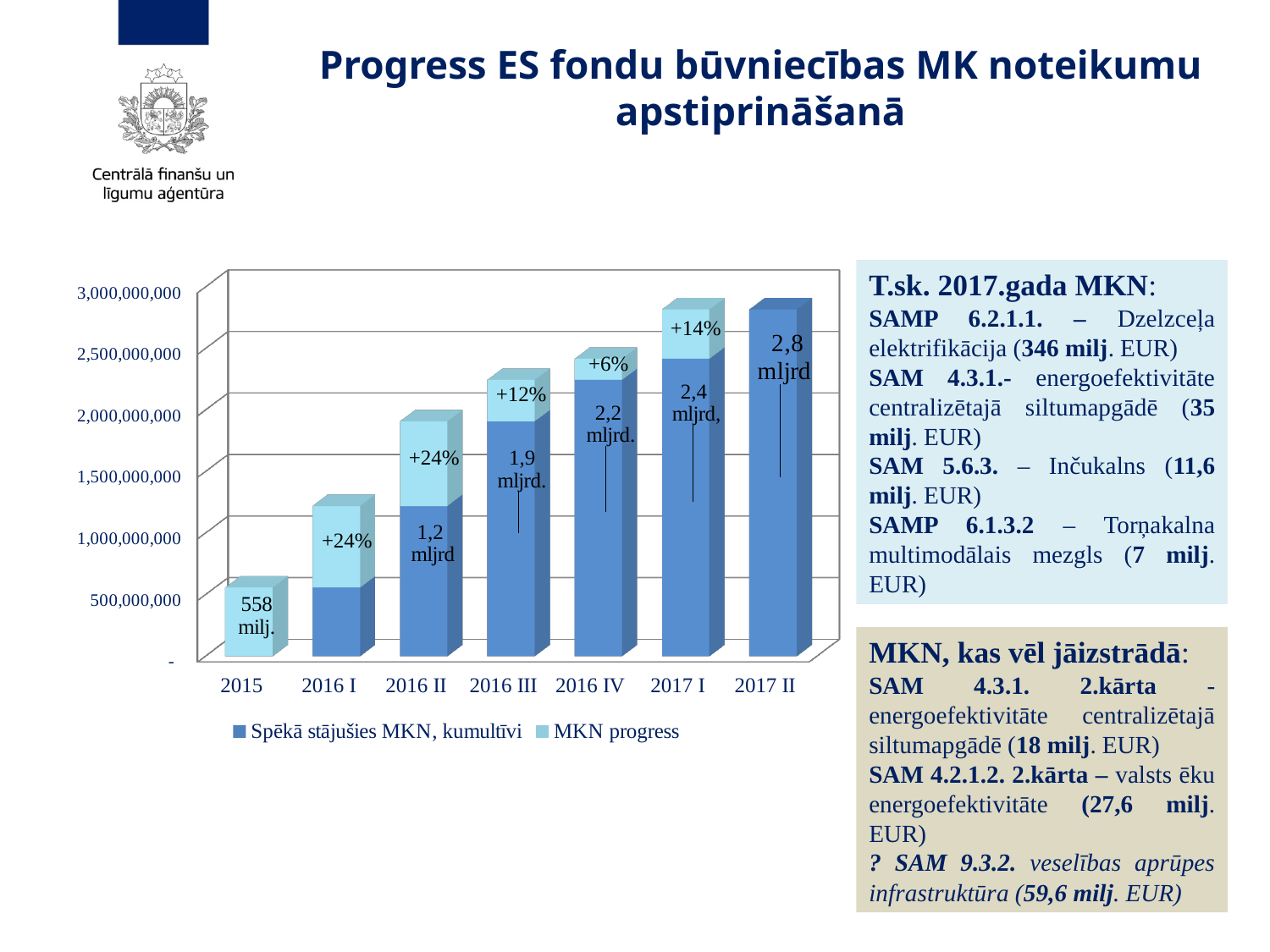
Which category has the tallest bar in the chart? 2017 II What value label is shown on the 2015 bar? 558 milj. What are the two series named in the chart legend? Spēkā stājušies MKN, kumultīvi; MKN progress What percentage label is shown on the 2016 III bar? +12% What percentage label is shown on the 2016 IV bar? +6% What percentage label is shown on the 2017 I bar? +14% How many categories are shown on the x axis of the chart? 7 How many series does the chart legend list? 2 What kind of chart is shown on the slide? Stacked bar chart Which category has the shortest bar in the chart? 2015 What value label is shown on the 2017 II bar? 2,8 mljrd Is the total value for 2015 greater or less than 1,000,000,000? less